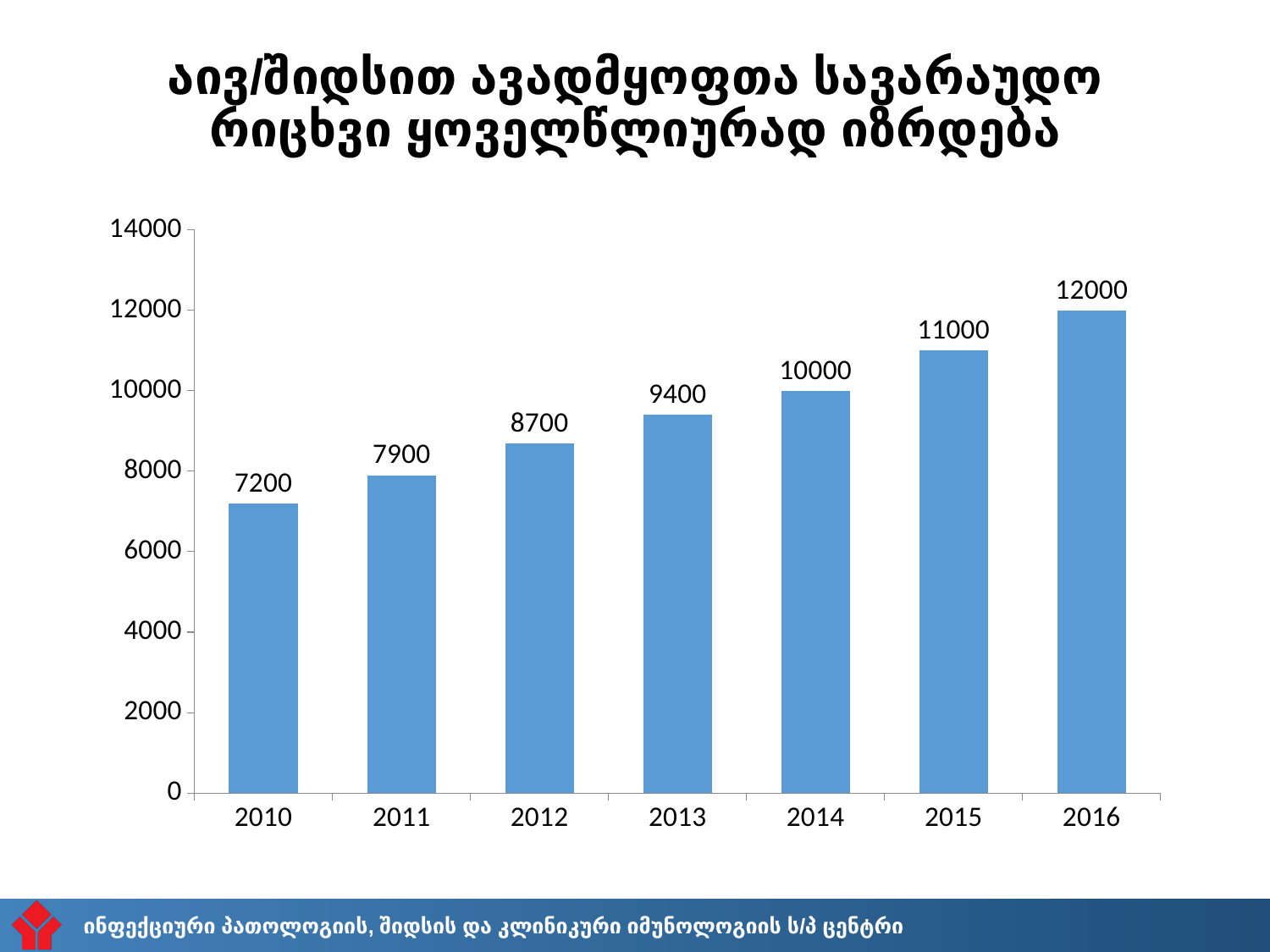
Which is larger, the value for 2014 or the value for 2012? 2014 Do the values rise or fall from 2010 to 2016? rise Which year has the highest value? 2016 What is the difference between the values for 2016 and 2010? 4800 Is the value for 2015 greater or less than 10000? greater What is the value for 2013? 9400 What is the value for 2016? 12000 Which year has the lowest value? 2010 What kind of chart is shown on the slide? bar chart What is the difference between the values for 2012 and 2011? 800 How many years are shown on the x axis? 7 What is the value for 2010? 7200